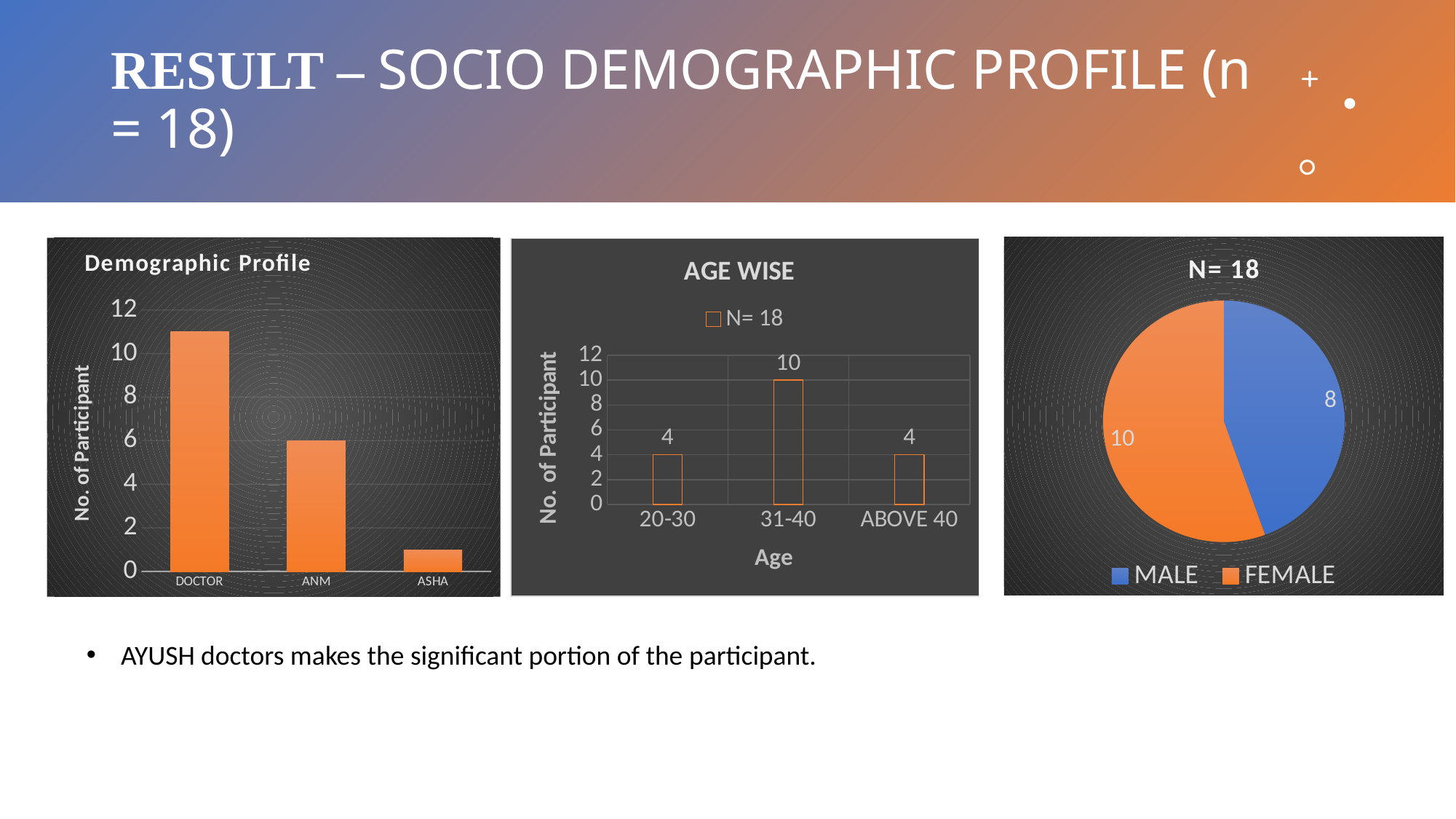
In the 'AGE WISE' chart, what is the difference between the 31-40 group and the ABOVE 40 group? 6 In the 'Demographic Profile' chart, is the value for DOCTOR greater or less than 10? greater In the 'Demographic Profile' chart, which category has the lowest number of participants? ASHA In the 'AGE WISE' chart, how many age groups are shown on the x axis? 3 In the 'Demographic Profile' chart, which category has the highest number of participants? DOCTOR In the 'AGE WISE' chart, which age group has the highest number of participants? 31-40 In the pie chart titled 'N= 18', what is the difference between FEMALE and MALE participants? 2 In the 'AGE WISE' chart, what is the number of participants aged 31-40? 10 In the 'AGE WISE' chart, what is the number of participants aged 20-30? 4 What kind of chart is the chart titled 'N= 18'? Pie chart In the pie chart titled 'N= 18', which is larger, MALE or FEMALE? FEMALE In the pie chart titled 'N= 18', how many participants are FEMALE? 10